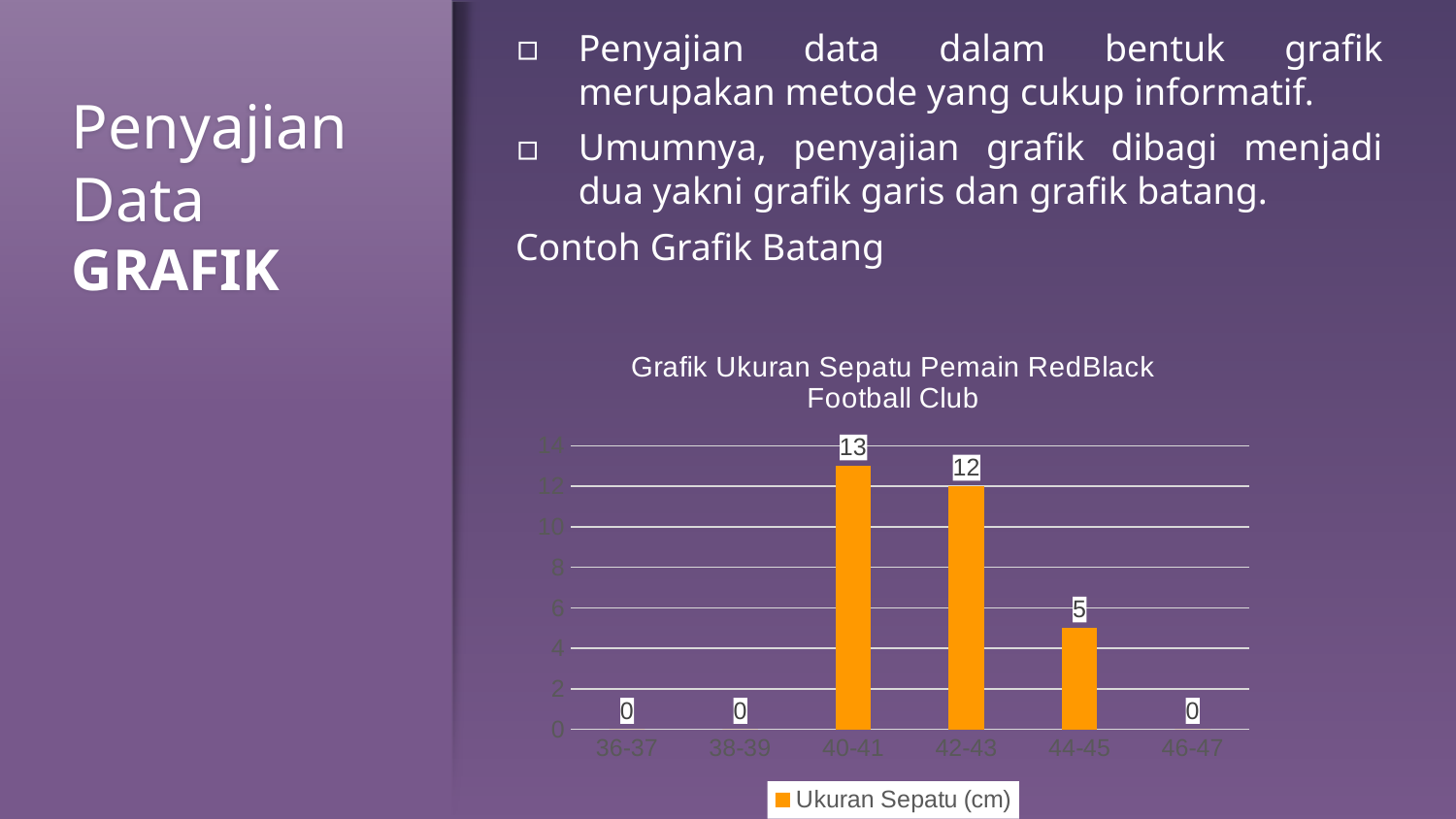
Which category has the highest value? 40-41 What is the value for the 44-45 category? 5 Which is larger, the value for 42-43 or the value for 44-45? 42-43 What is the difference between the values for 40-41 and 44-45? 8 How many categories are shown on the x axis? 6 What is the value for the 42-43 category? 12 What is the title of the chart? Grafik Ukuran Sepatu Pemain RedBlack Football Club What is the value for the 40-41 category? 13 How many series does the legend list? 1 What is the value for the 36-37 category? 0 What is the difference between the values for 42-43 and 44-45? 7 What kind of chart is shown on the slide? bar chart